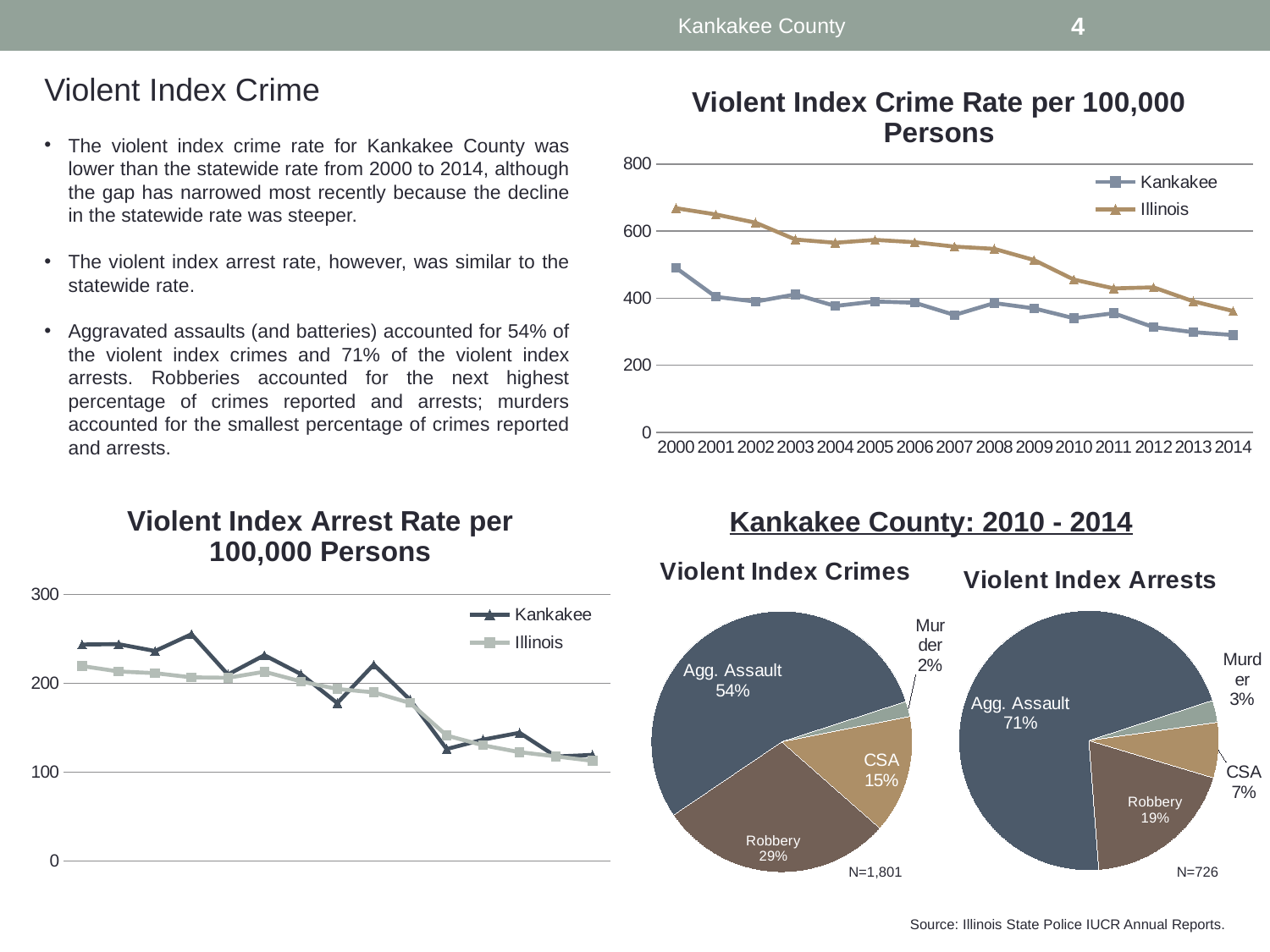
In the Violent Index Crimes pie chart, which category has the smallest slice? Murder In the Violent Index Arrests pie chart, which category has the largest slice? Agg. Assault What kind of chart is the Violent Index Arrest Rate per 100,000 Persons chart? Line chart How many percentage points higher is the Agg. Assault share in the Violent Index Arrests pie chart than in the Violent Index Crimes pie chart? 17 percentage points What N value is shown on the Violent Index Crimes pie chart? N=1,801 In the Violent Index Crimes pie chart, what share of crimes is Agg. Assault? 54% In the Violent Index Arrests pie chart, what share of arrests is Robbery? 19% In the Violent Index Crime Rate per 100,000 Persons chart, how many series does the legend list? 2 In the Violent Index Crime Rate per 100,000 Persons chart, which series has the higher value in 2000, Kankakee or Illinois? Illinois In the Violent Index Crime Rate per 100,000 Persons chart, is the Illinois value for 2000 greater or less than 600? greater In the Violent Index Crime Rate per 100,000 Persons chart, does the Illinois rate generally rise or fall from 2000 to 2014? Fall How many slices does the Violent Index Crimes pie chart have? 4